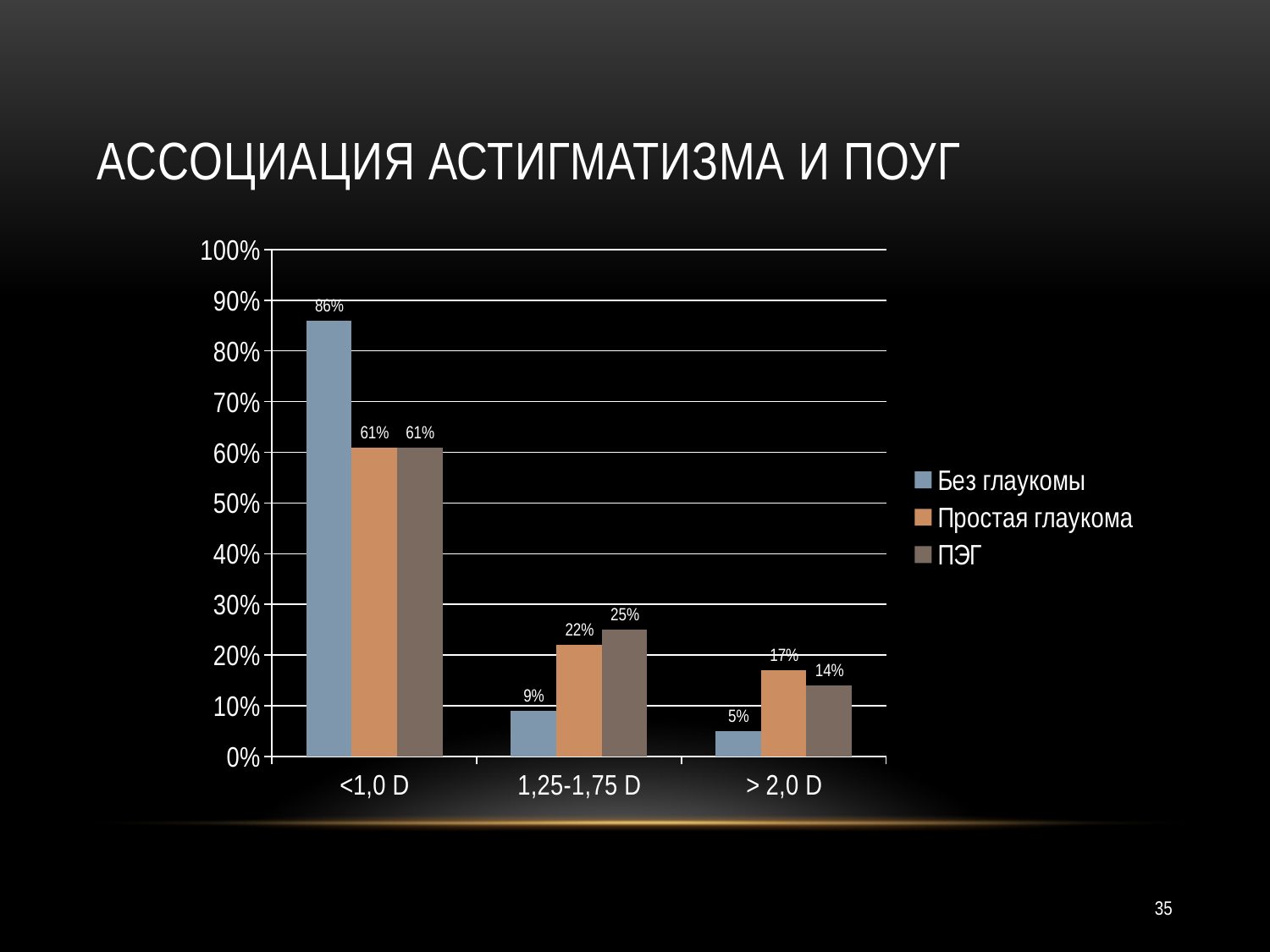
Is the value for Без глаукомы in the > 2,0 D category greater or less than 10%? less Which category has the lowest value for ПЭГ? > 2,0 D What is the title of the slide? АССОЦИАЦИЯ АСТИГМАТИЗМА И ПОУГ What is the value for Без глаукомы in the <1,0 D category? 86% Which is larger in the 1,25-1,75 D category: Простая глаукома or ПЭГ? ПЭГ What is the difference between Без глаукомы and Простая глаукома in the <1,0 D category? 25% What is the value for Простая глаукома in the > 2,0 D category? 17% How many categories are shown on the x axis? 3 What is the value for ПЭГ in the 1,25-1,75 D category? 25% How many series does the legend list? 3 What kind of chart is shown on the slide? bar chart Which category has the highest value for Без глаукомы? <1,0 D